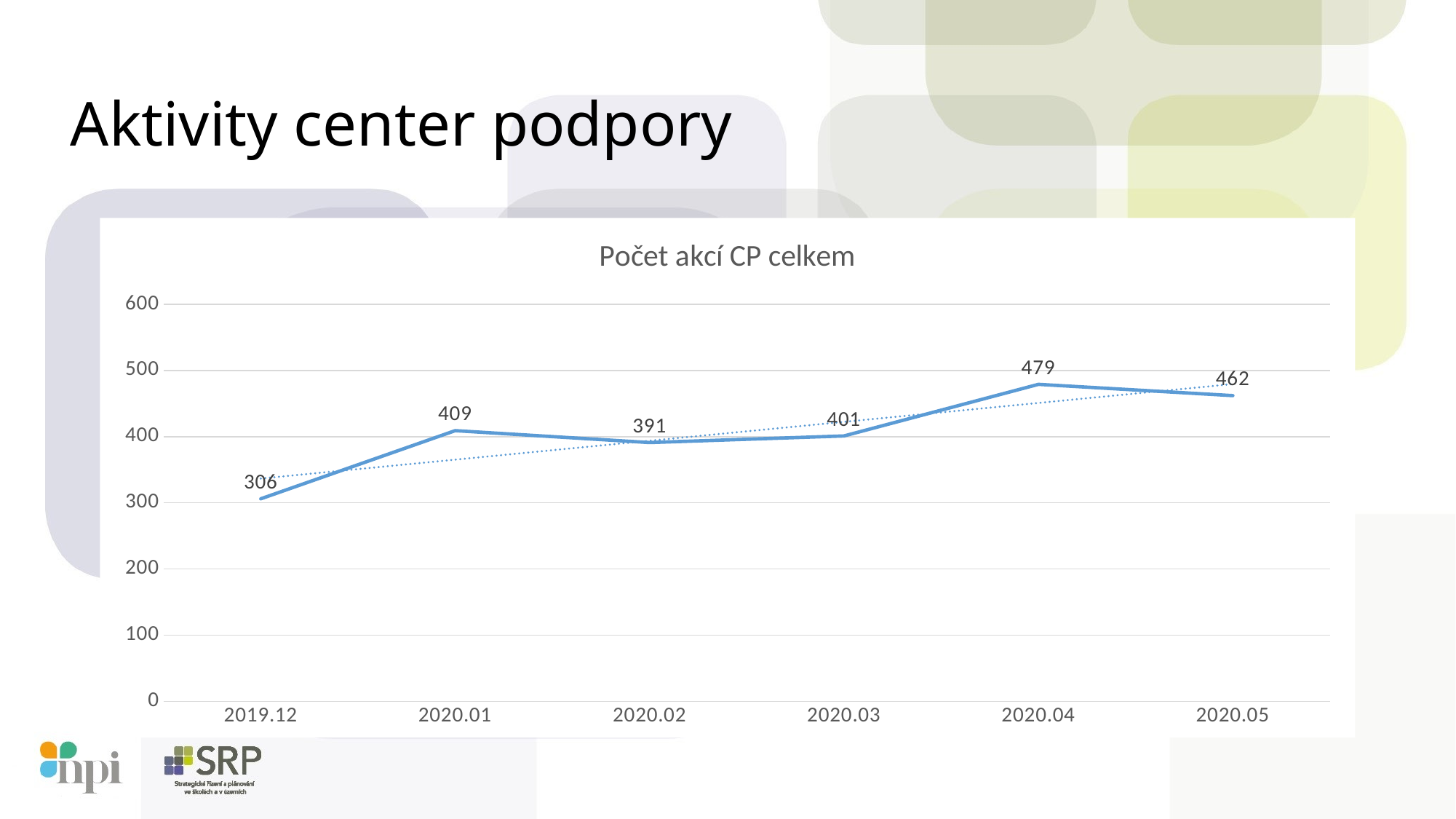
What is the title of the chart? Počet akcí CP celkem What is the value for 2020.04? 479 What is the value for 2020.05? 462 How many months are plotted on the chart? 6 What is the value for 2020.02? 391 What is the difference between the values for 2020.01 and 2019.12? 103 What is the difference between the values for 2020.04 and 2020.05? 17 Which month has the highest value? 2020.04 Which is larger, the value for 2020.01 or the value for 2020.03? 2020.01 What is the value for 2019.12? 306 Which month has the lowest value? 2019.12 What kind of chart is shown? line chart